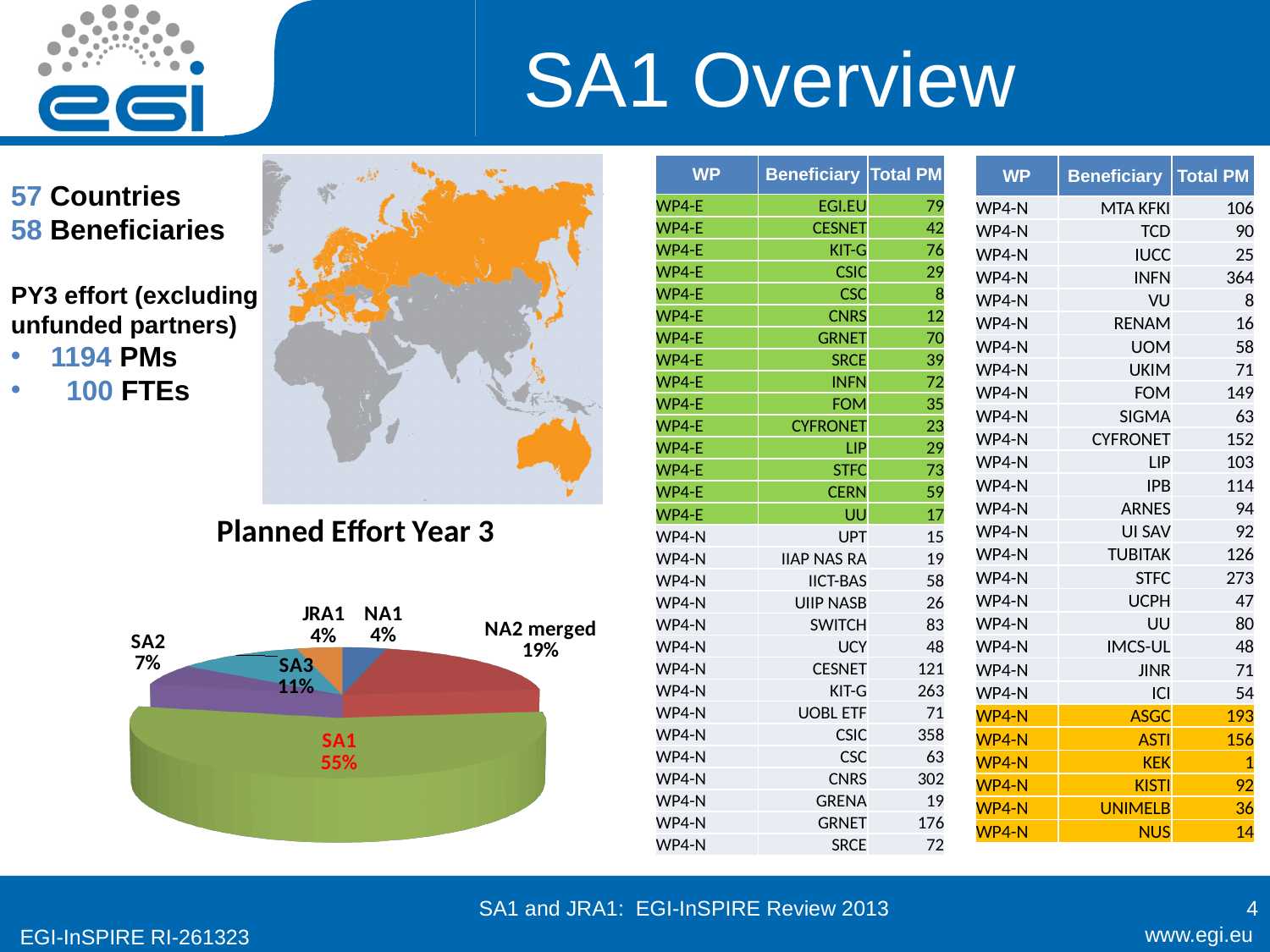
In the 'Planned Effort Year 3' pie chart, which slice is the largest? SA1 In the 'Planned Effort Year 3' pie chart, what share does SA1 have? 55% In the 'Planned Effort Year 3' pie chart, what is the difference in percentage points between SA1 and NA2 merged? 36 What is the title of the pie chart on the slide? Planned Effort Year 3 In the 'Planned Effort Year 3' pie chart, what share does JRA1 have? 4% In the 'Planned Effort Year 3' pie chart, what share does NA2 merged have? 19% In the 'Planned Effort Year 3' pie chart, which is larger, SA3 or SA2? SA3 In the 'Planned Effort Year 3' pie chart, what is the combined share of JRA1 and NA1? 8% In the 'Planned Effort Year 3' pie chart, how many slices are there? 6 What kind of chart is 'Planned Effort Year 3'? pie chart In the 'Planned Effort Year 3' pie chart, what share does SA2 have? 7% In the 'Planned Effort Year 3' pie chart, what share does SA3 have? 11%